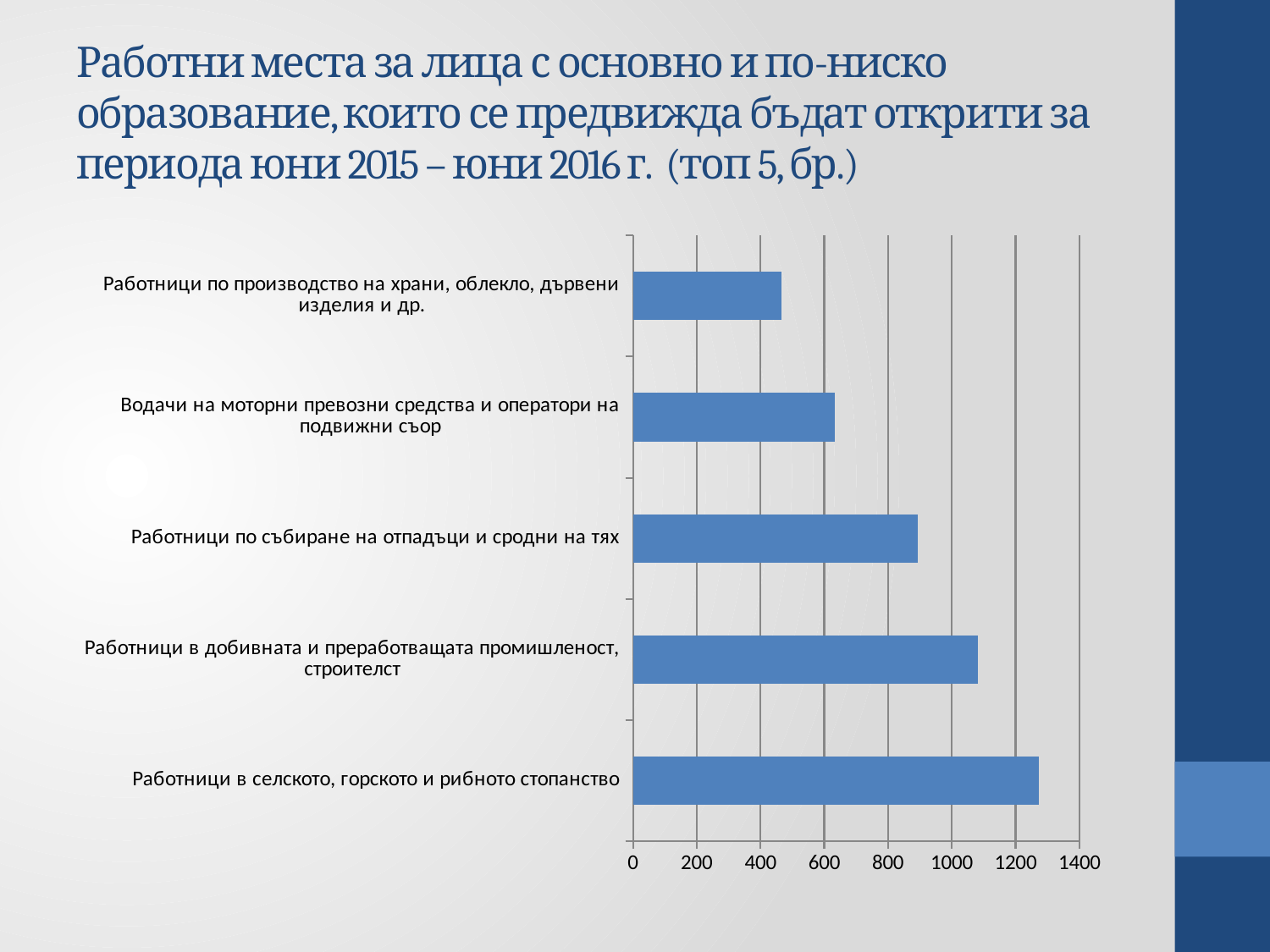
Which category has the highest value? Работници в селското, горското и рибното стопанство Is the value for 'Работници по производство на храни, облекло, дървени изделия и др.' greater or less than 600? less Is the value for 'Работници в добивната и преработващата промишленост, строителст' greater or less than 1000? greater Which category has the lowest value? Работници по производство на храни, облекло, дървени изделия и др. What is the highest value shown on the horizontal axis of the chart? 1400 Is the value for 'Работници по събиране на отпадъци и сродни на тях' greater or less than 800? greater Which is larger: the value for 'Работници в добивната и преработващата промишленост, строителст' or the value for 'Работници в селското, горското и рибното стопанство'? Работници в селското, горското и рибното стопанство Which is larger: the value for 'Работници по събиране на отпадъци и сродни на тях' or the value for 'Водачи на моторни превозни средства и оператори на подвижни съор'? Работници по събиране на отпадъци и сродни на тях What kind of chart is shown on the slide? bar chart How many categories are plotted in the chart? 5